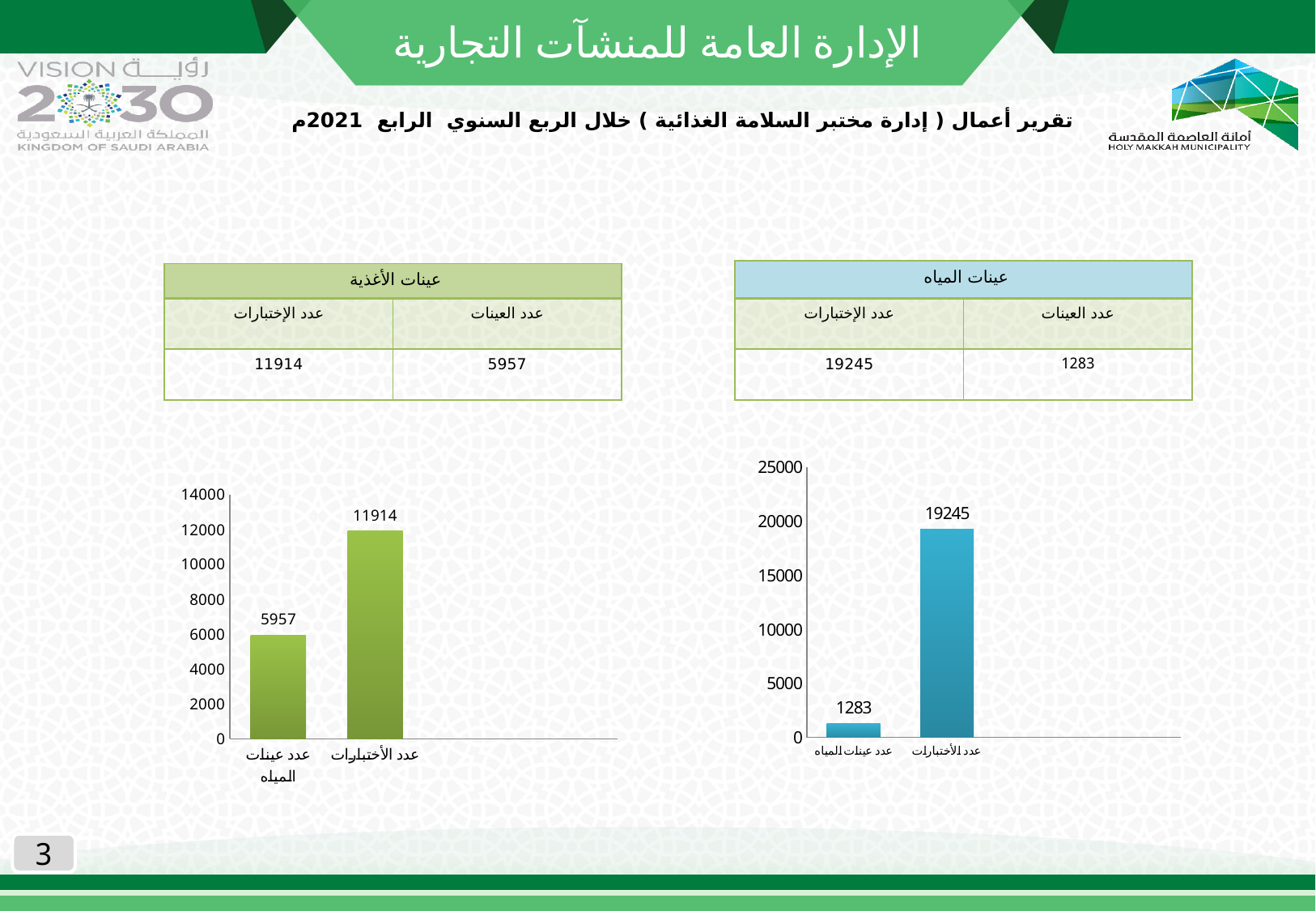
In the right chart, which category has the lowest value? عدد عينات المياه In the left chart, what is the value for عدد عينات المياه? 5957 In the left chart, what is the value for عدد الأختبارات? 11914 In the left chart, what is the difference between عدد الأختبارات and عدد عينات المياه? 5957 How many bars are plotted in the left chart? 2 What is the highest value shown on the vertical axis of the right chart? 25000 What kind of chart is the right chart? bar chart In the right chart, what is the value for عدد عينات المياه? 1283 In the right chart, is the value for عدد الأختبارات greater or less than 15000? greater In the right chart, what is the difference between عدد الأختبارات and عدد عينات المياه? 17962 In the left chart, which category has the highest value? عدد الأختبارات In the right chart, what is the value for عدد الأختبارات? 19245